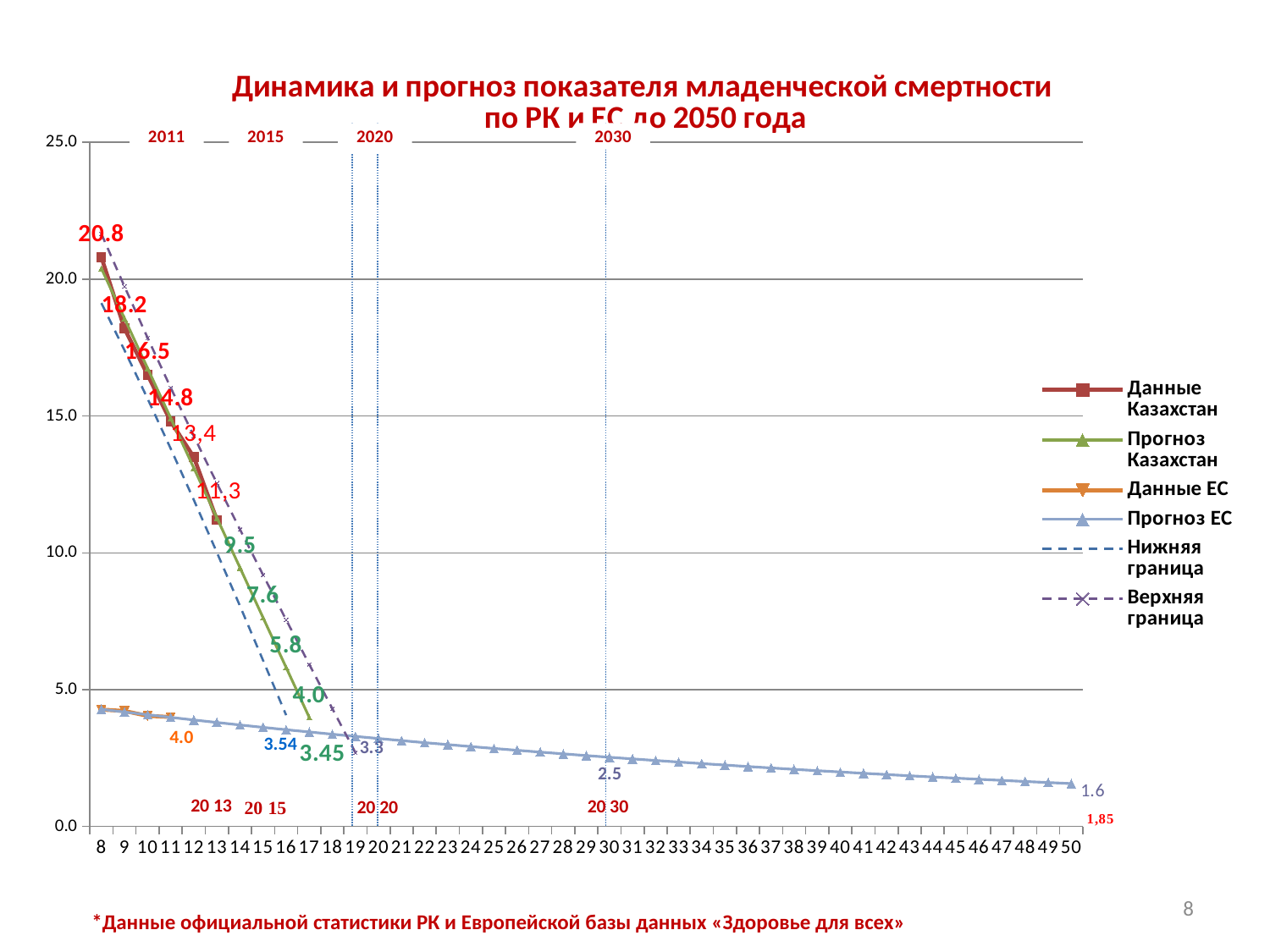
How many series does the legend list? 6 Do the values of the Данные Казахстан series rise or fall along the x axis? fall What is the first labelled value of the Данные Казахстан series (at x = 8)? 20.8 What is the highest labelled value on the chart? 20.8 What kind of chart is shown on the slide? line chart Is the value of the Данные ЕС series at x = 8 greater or less than 5.0? less What is the title of the chart? Динамика и прогноз показателя младенческой смертности по РК и ЕС до 2050 года What is the difference between the first two labelled values of Данные Казахстан, 20.8 and 18.2? 2.6 What value is labelled on the Прогноз ЕС series at the 2030 marker (x = 30)? 2.5 What is the last labelled value of the Прогноз ЕС series (at x = 50)? 1.6 What value is labelled on the Прогноз ЕС series at the 2020 marker (x = 20)? 3.3 Which is larger: the Данные Казахстан value at x = 12 (13.4) or at x = 13 (11.3)? 13.4